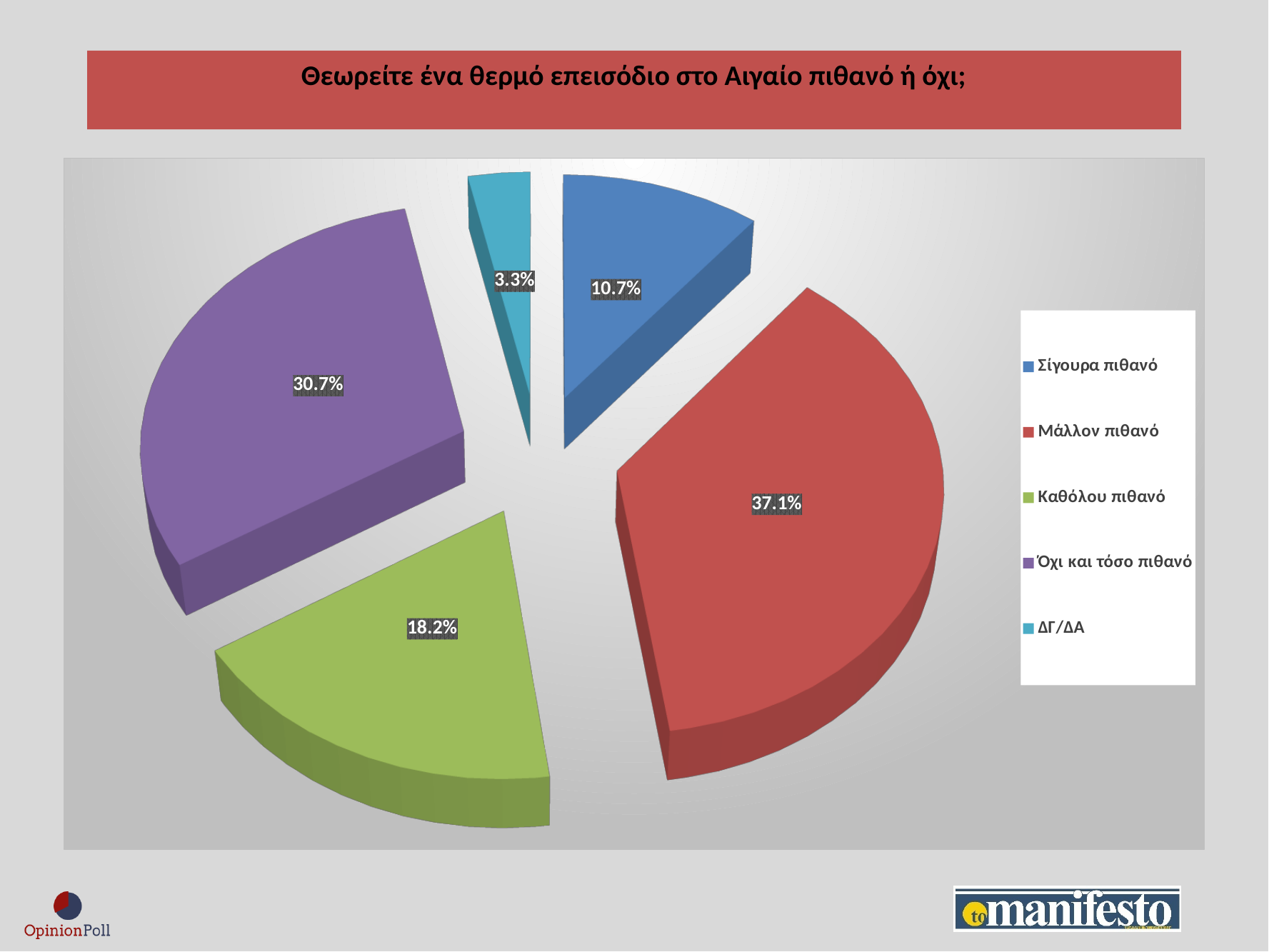
What percentage of respondents answered "Καθόλου πιθανό"? 18.2% Which response has the smallest share of the pie? ΔΓ/ΔΑ How many categories does the legend list? 5 What kind of chart is shown on the slide? Pie chart What percentage of respondents answered "ΔΓ/ΔΑ"? 3.3% What percentage of respondents answered "Μάλλον πιθανό"? 37.1% Which response has the largest share of the pie? Μάλλον πιθανό Which is larger, the share for "Καθόλου πιθανό" or the share for "Σίγουρα πιθανό"? Καθόλου πιθανό What percentage of respondents answered "Όχι και τόσο πιθανό"? 30.7% What percentage of respondents answered "Σίγουρα πιθανό"? 10.7% What colour is the slice for "Όχι και τόσο πιθανό"? Purple What is the difference in percentage points between "Μάλλον πιθανό" and "Όχι και τόσο πιθανό"? 6.4